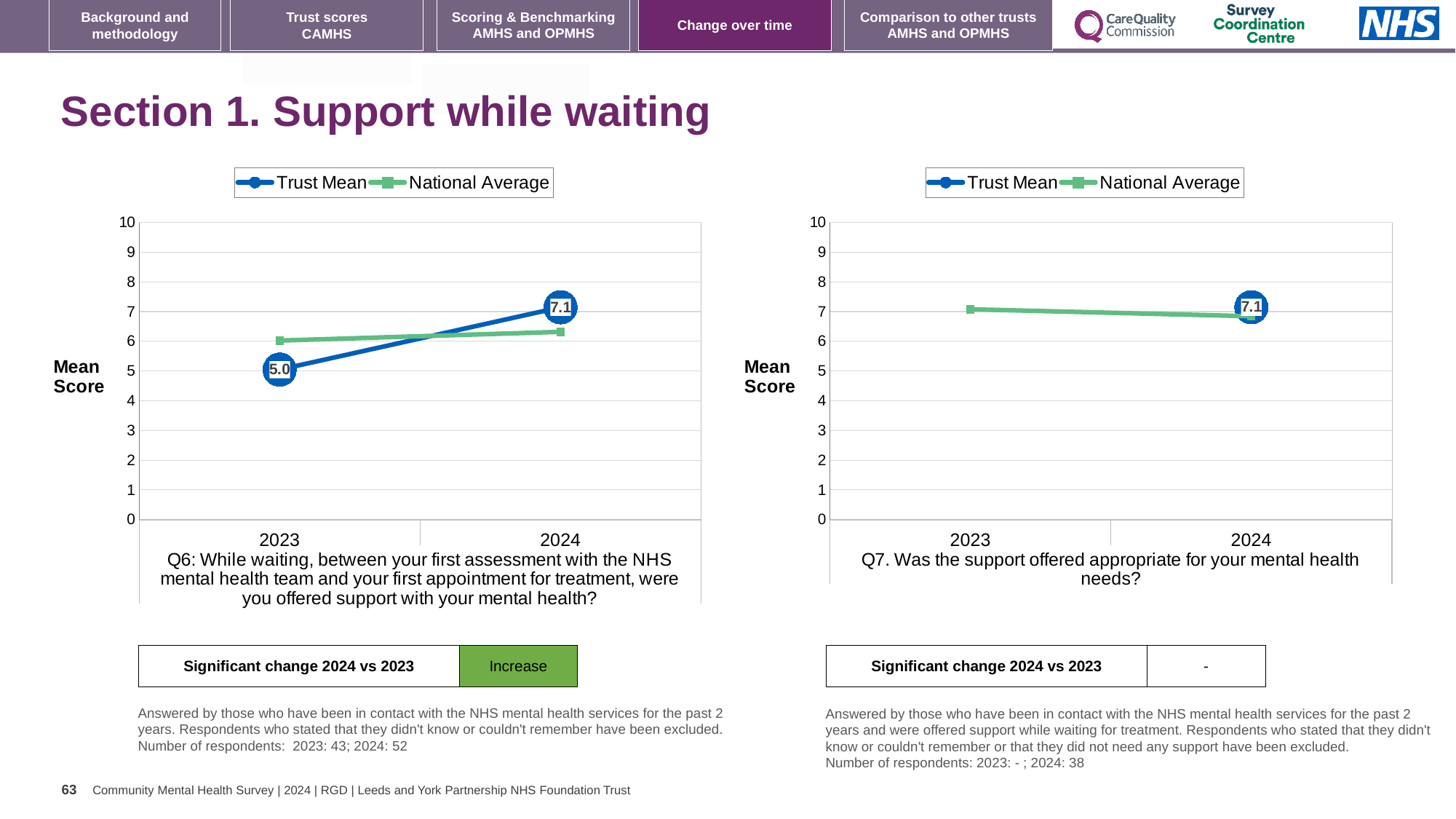
How many series does the legend of the right chart (Q7) list? 2 In the left chart (Q6), what is the Trust Mean score for 2023? 5.0 What type of chart is the left chart (Q6)? line chart In the left chart (Q6), which year has the higher Trust Mean score? 2024 In the left chart (Q6), what is the Trust Mean score for 2024? 7.1 In the right chart (Q7), what is the Trust Mean score for 2024? 7.1 How many years are shown on the x axis of the left chart (Q6)? 2 In the left chart (Q6), is the Trust Mean for 2023 greater or less than the National Average for 2023? less In the left chart (Q6), what is the difference between the Trust Mean scores for 2024 and 2023? 2.1 In the left chart (Q6), does the Trust Mean rise or fall from 2023 to 2024? rise In the left chart (Q6), is the National Average for 2023 greater or less than 5? greater In the right chart (Q7), is the National Average for 2023 greater or less than 6? greater